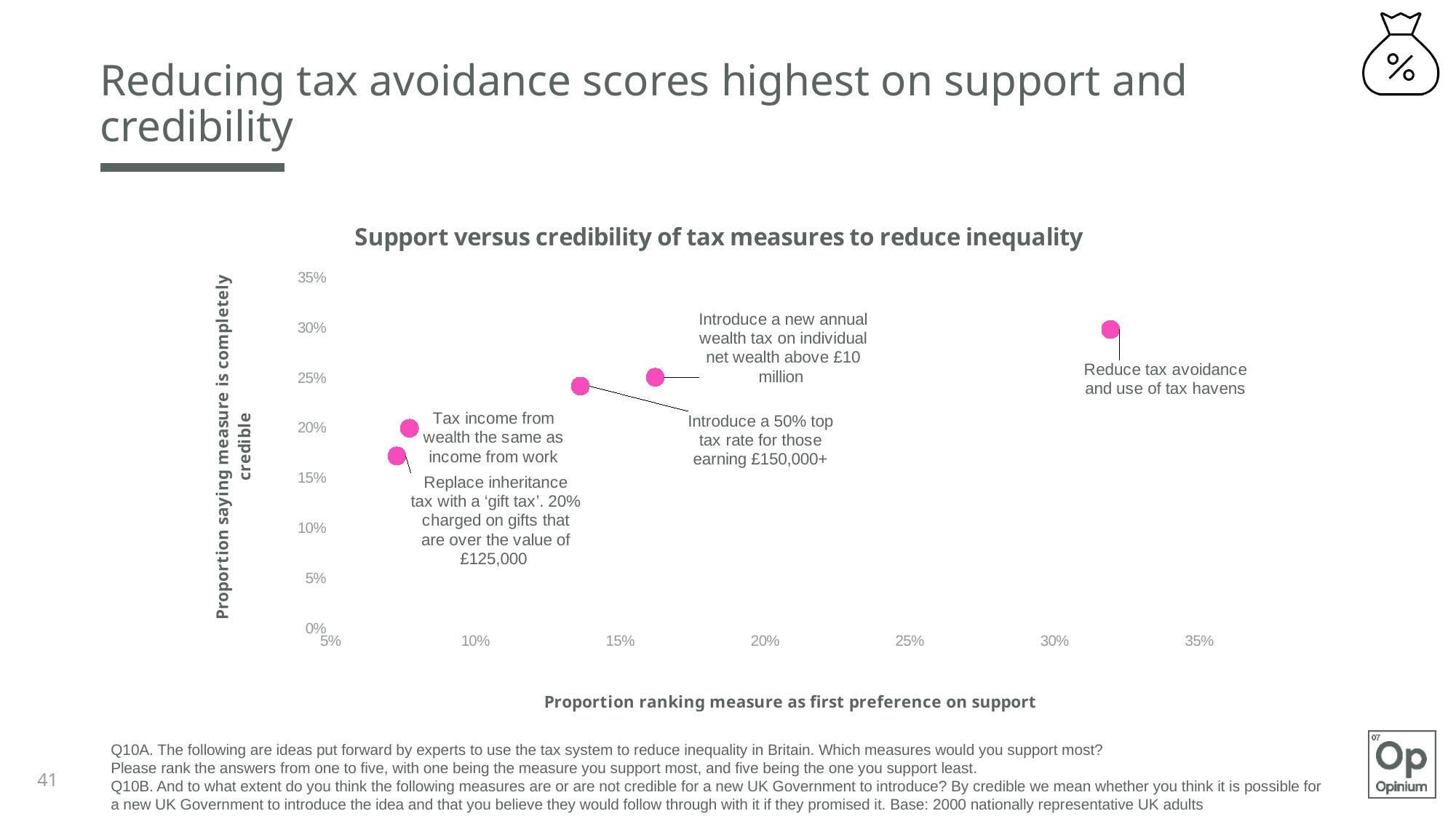
How many tax measures are plotted on the chart? 5 Is the proportion ranking 'Reduce tax avoidance and use of tax havens' as first preference on support greater or less than 30%? greater Which has a higher proportion saying it is completely credible: 'Introduce a new annual wealth tax on individual net wealth above £10 million' or 'Tax income from wealth the same as income from work'? Introduce a new annual wealth tax on individual net wealth above £10 million Is the proportion ranking 'Introduce a new annual wealth tax on individual net wealth above £10 million' as first preference on support greater or less than 20%? less Which tax measure has the lowest proportion saying it is completely credible? Replace inheritance tax with a 'gift tax'. 20% charged on gifts that are over the value of £125,000 Which tax measure has the highest proportion ranking it as first preference on support? Reduce tax avoidance and use of tax havens Is the proportion saying 'Replace inheritance tax with a gift tax' is completely credible greater or less than 20%? less What is the title of the chart? Support versus credibility of tax measures to reduce inequality What kind of chart is shown on the slide? Scatter chart Which has a higher proportion ranking it as first preference on support: 'Introduce a 50% top tax rate for those earning £150,000+' or 'Tax income from wealth the same as income from work'? Introduce a 50% top tax rate for those earning £150,000+ Which tax measure has the highest proportion saying it is completely credible? Reduce tax avoidance and use of tax havens